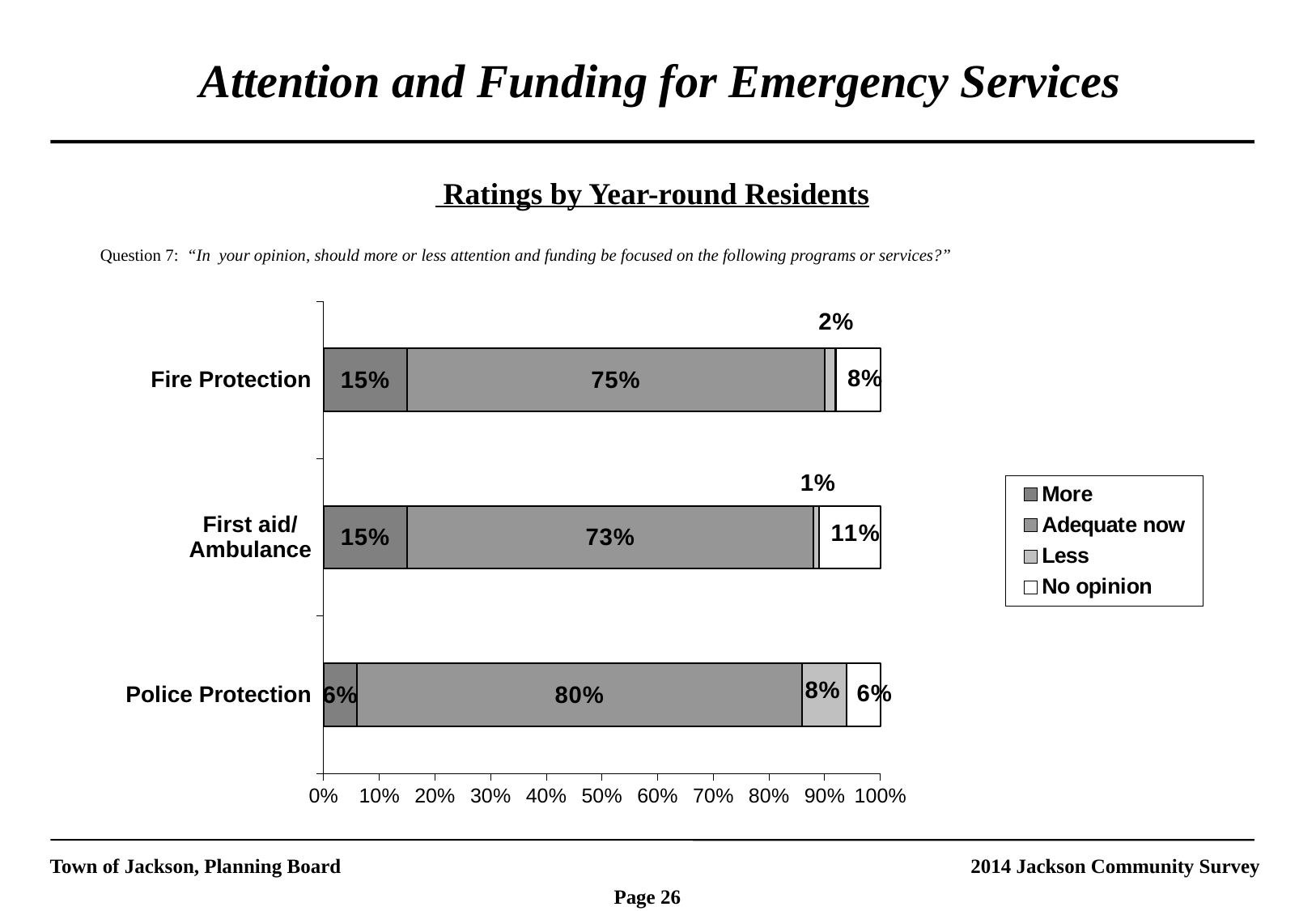
What is the 'Adequate now' value for Fire Protection? 75% Which service has the highest 'Adequate now' value? Police Protection How many series does the legend list? 4 What kind of chart is shown on the slide? Stacked bar chart Which service has the lowest 'More' value? Police Protection How many categories (services) are shown on the chart? 3 What is the 'No opinion' value for First aid/Ambulance? 11% What is the 'More' value for Police Protection? 6% Which is larger: the 'No opinion' value for First aid/Ambulance or for Fire Protection? First aid/Ambulance What is the total of the stacked bar for Fire Protection? 100% What is the difference between the 'Adequate now' values for Police Protection and First aid/Ambulance? 7% What is the 'Less' value for Police Protection? 8%